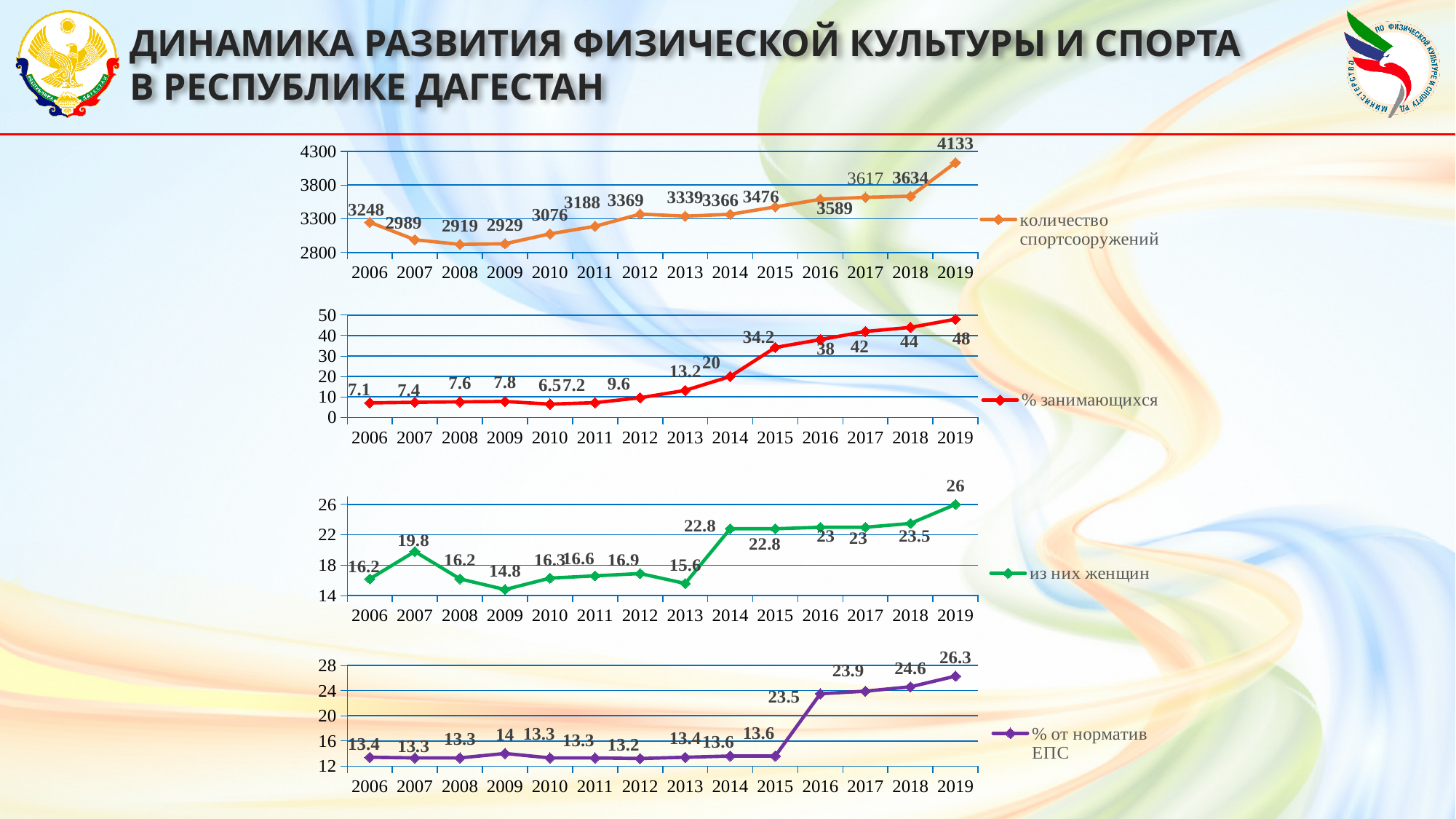
In the second chart (% занимающихся), which year has the lowest value? 2010 In the top chart (количество спортсооружений), what is the value for 2019? 4133 In the fourth chart (% от норматив ЕПС), which is larger, the value for 2009 or the value for 2012? 2009 In the fourth chart (% от норматив ЕПС), what is the value for 2016? 23.5 In the top chart (количество спортсооружений), which year has the lowest value? 2008 In the second chart (% занимающихся), is the value for 2019 greater or less than 40? greater In the third chart (из них женщин), what is the value for 2009? 14.8 How many years are plotted on the x axis of the top chart (количество спортсооружений)? 14 In the top chart (количество спортсооружений), what is the difference between the 2019 value and the 2018 value? 499 What type of chart is the second chart (% занимающихся)? line chart In the second chart (% занимающихся), what is the value for 2015? 34.2 In the third chart (из них женщин), which year has the highest value? 2019